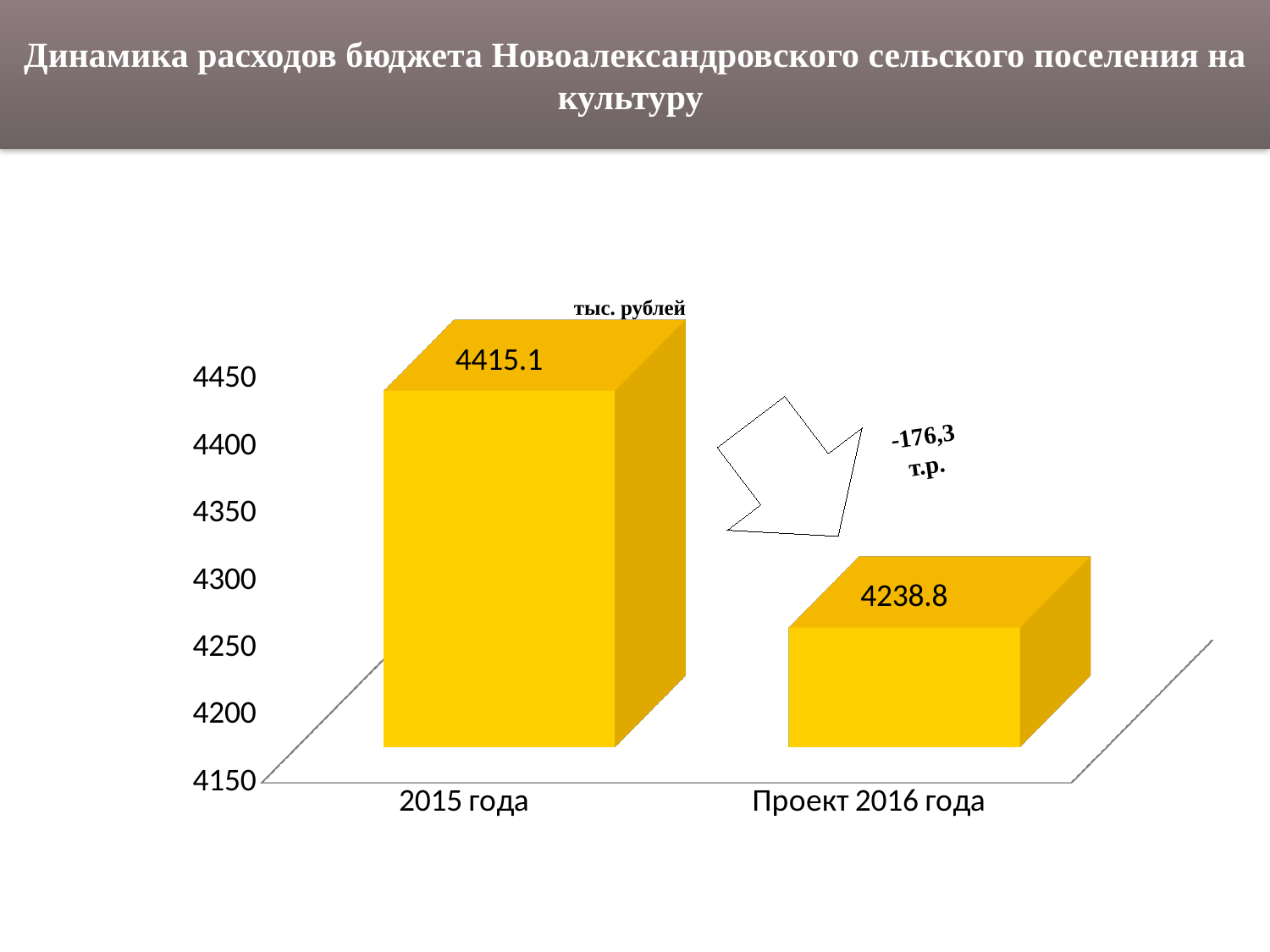
Is the value for Проект 2016 года greater or less than 4300? less What is the difference between the value for 2015 года and the value for Проект 2016 года? 176.3 What kind of chart is shown on the slide? bar chart Do the values rise or fall from 2015 года to Проект 2016 года? fall What is the value for 2015 года? 4415.1 Is the value for 2015 года greater or less than 4400? greater Which category has the lowest value? Проект 2016 года What unit is indicated above the chart? тыс. рублей What is the value for Проект 2016 года? 4238.8 How many categories are shown on the x axis? 2 Which category has the highest value? 2015 года Which is larger, the value for 2015 года or the value for Проект 2016 года? 2015 года